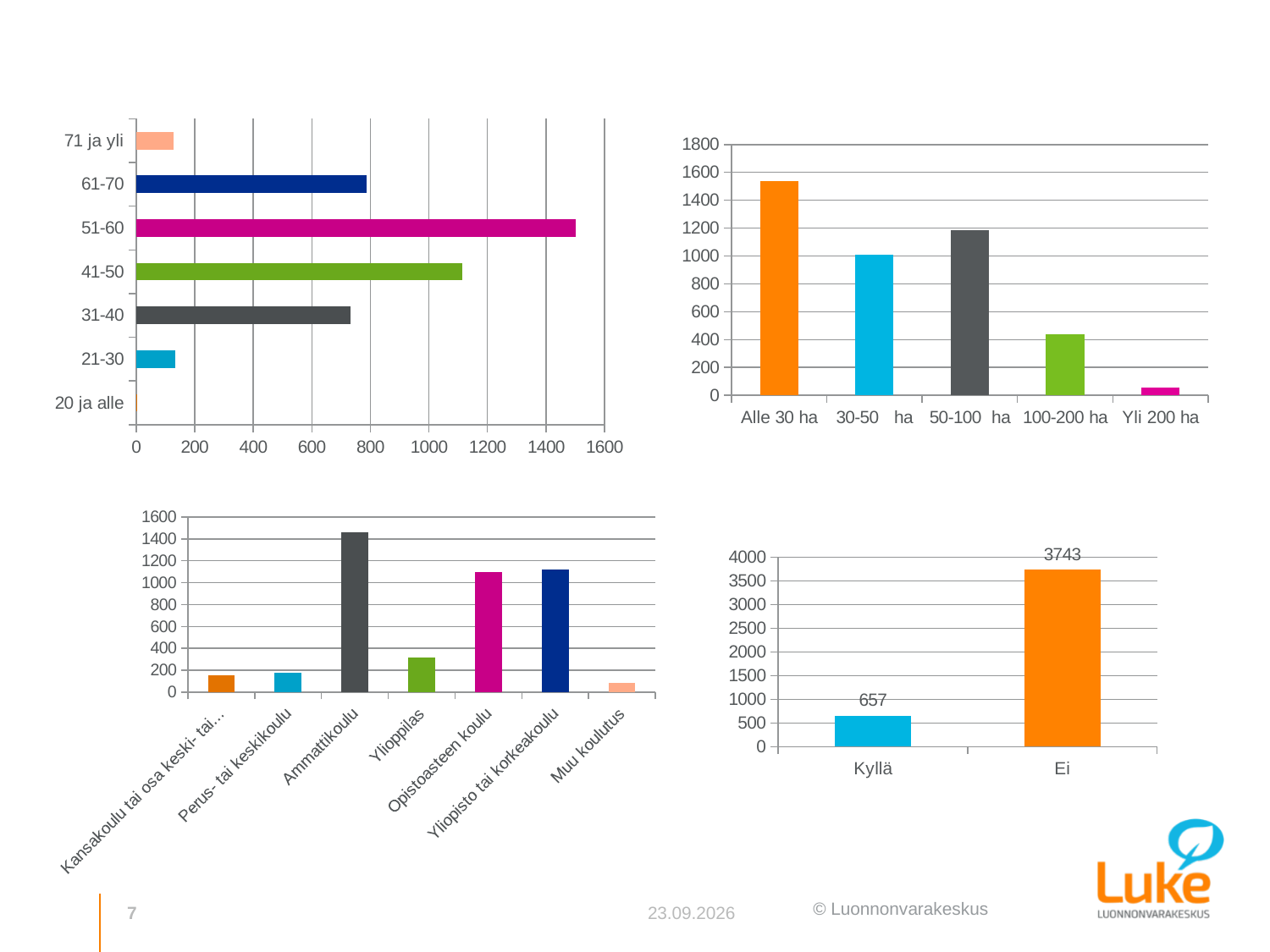
In the bottom-left chart, which category has the highest value? Ammattikoulu In the bottom-right chart, what is the value for Ei? 3743 In the top-right chart, which category has the lowest value? Yli 200 ha How many categories are shown in the top-right chart? 5 What kind of chart is the top-left chart? bar chart In the bottom-left chart, is the value for Ylioppilas greater or less than 400? less In the bottom-right chart, what is the value for Kyllä? 657 In the top-left chart, which is larger, the value for 41-50 or the value for 31-40? 41-50 In the top-left chart, is the value for 61-70 greater or less than 600? greater In the bottom-right chart, what is the difference between the values for Ei and Kyllä? 3086 In the top-left chart, which age group has the highest value? 51-60 In the top-right chart, which category has the highest value? Alle 30 ha